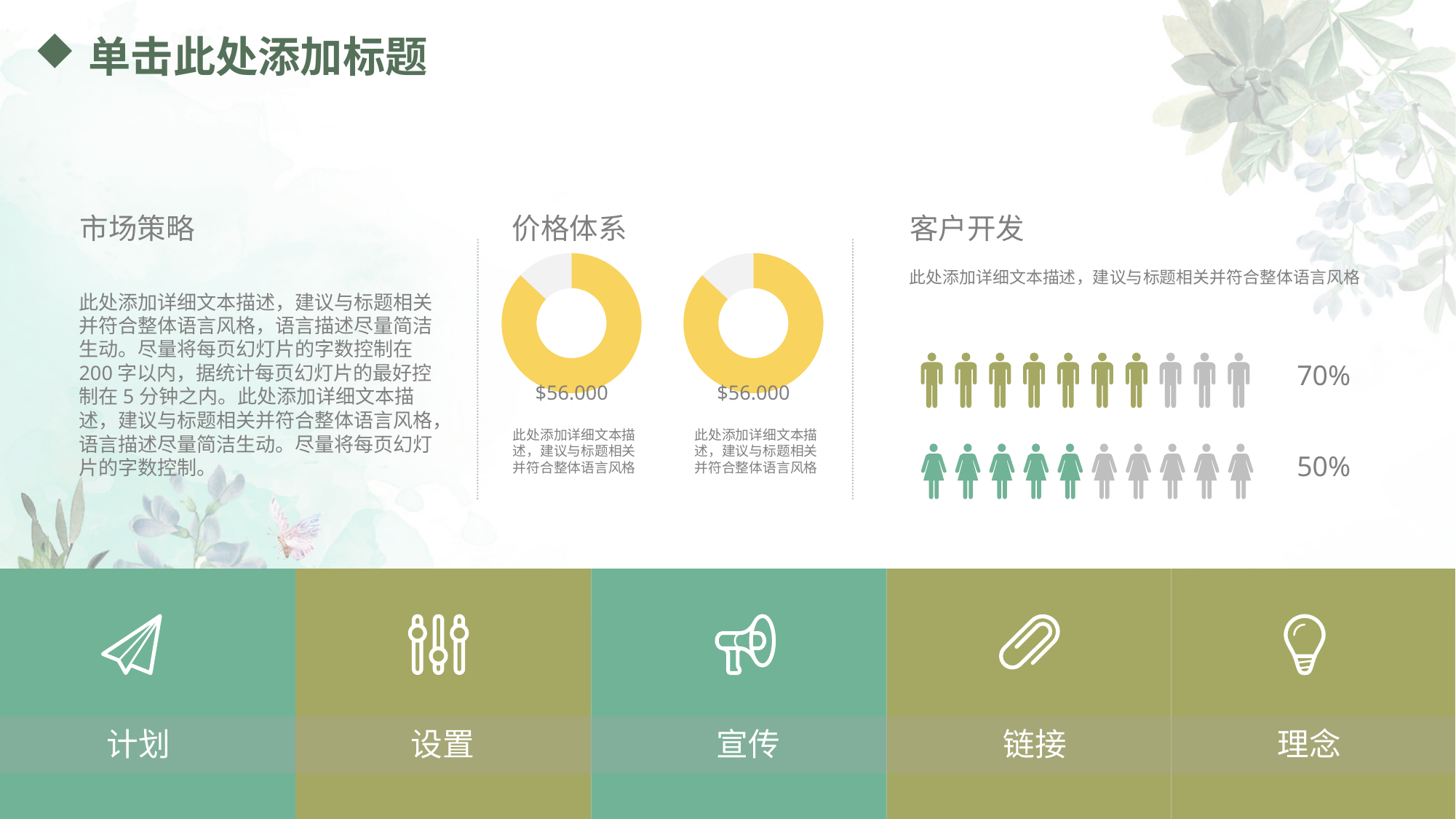
In the left doughnut chart under 价格体系, which slice is larger, the yellow one or the grey one? the yellow one In the pictograph under 客户开发, how many figures in the top row are coloured green? 7 What value is printed below the right doughnut chart under 价格体系? $56.000 In the pictograph under 客户开发, which row has the higher percentage, the top row or the bottom row? the top row What kind of chart is the left chart under 价格体系? doughnut chart In the pictograph under 客户开发, what is the difference between the top row percentage and the bottom row percentage? 20% What value is printed below the left doughnut chart under 价格体系? $56.000 In the pictograph under 客户开发, what percentage is shown for the bottom row of figures? 50% What colour is the larger slice in the right doughnut chart under 价格体系? yellow In the pictograph under 客户开发, how many figure icons are in each row? 10 How many slices does the right doughnut chart under 价格体系 have? 2 In the pictograph under 客户开发, what percentage is shown for the top row of figures? 70%